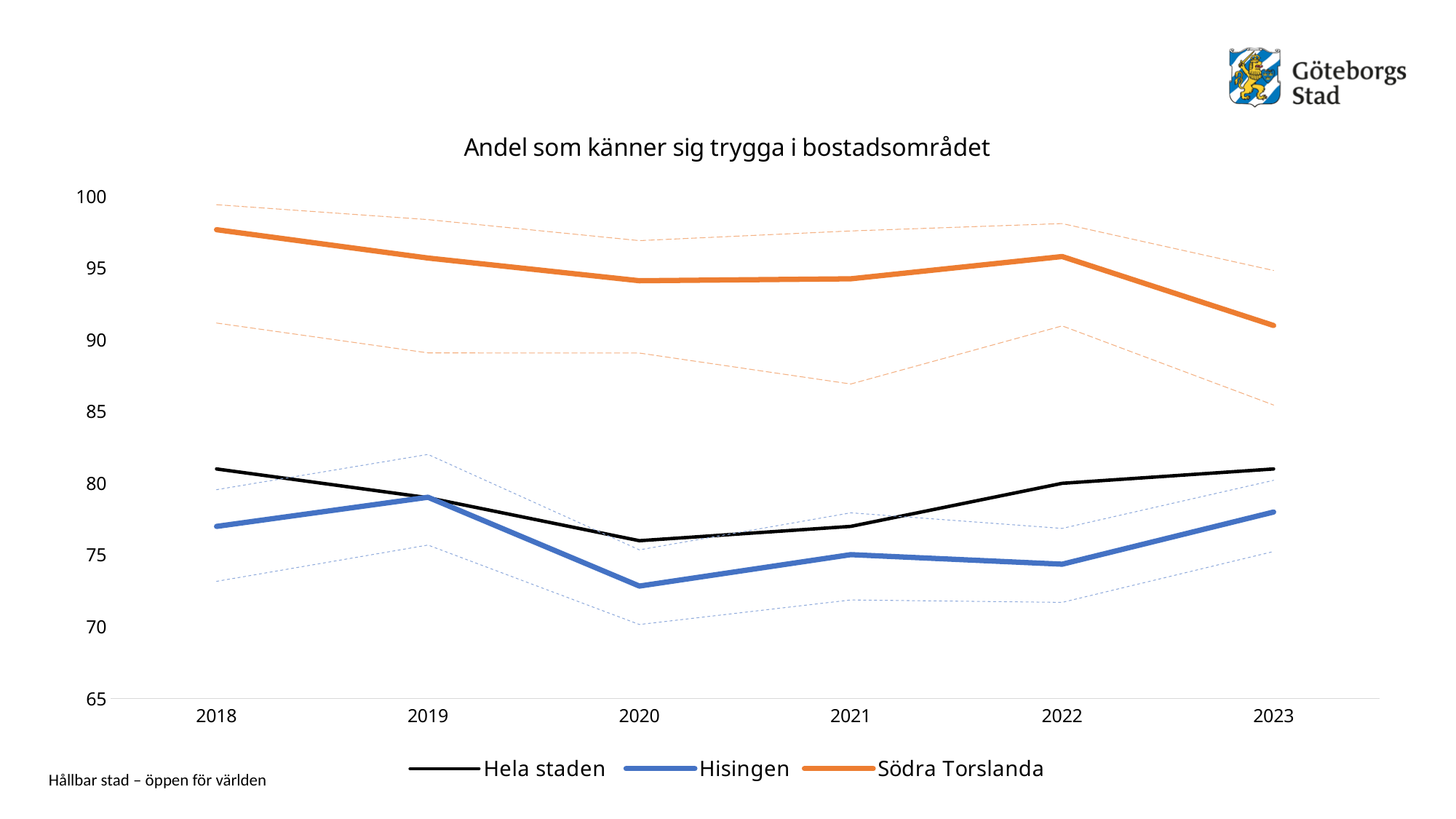
Does the Södra Torslanda line rise or fall from 2022 to 2023? fall What kind of chart is shown on the slide? line chart Is the value for Södra Torslanda in 2018 greater or less than 95? greater Which series has the lowest value in 2020? Hisingen What is the title of the chart? Andel som känner sig trygga i bostadsområdet In which year is the Hisingen line at its lowest? 2020 How many series does the legend list? 3 Is the value for Hisingen in 2020 greater or less than 75? less In which year is the Södra Torslanda line at its lowest? 2023 How many years are shown on the x axis? 6 Which series has the highest value in 2021? Södra Torslanda Which is larger in 2018, Hela staden or Hisingen? Hela staden